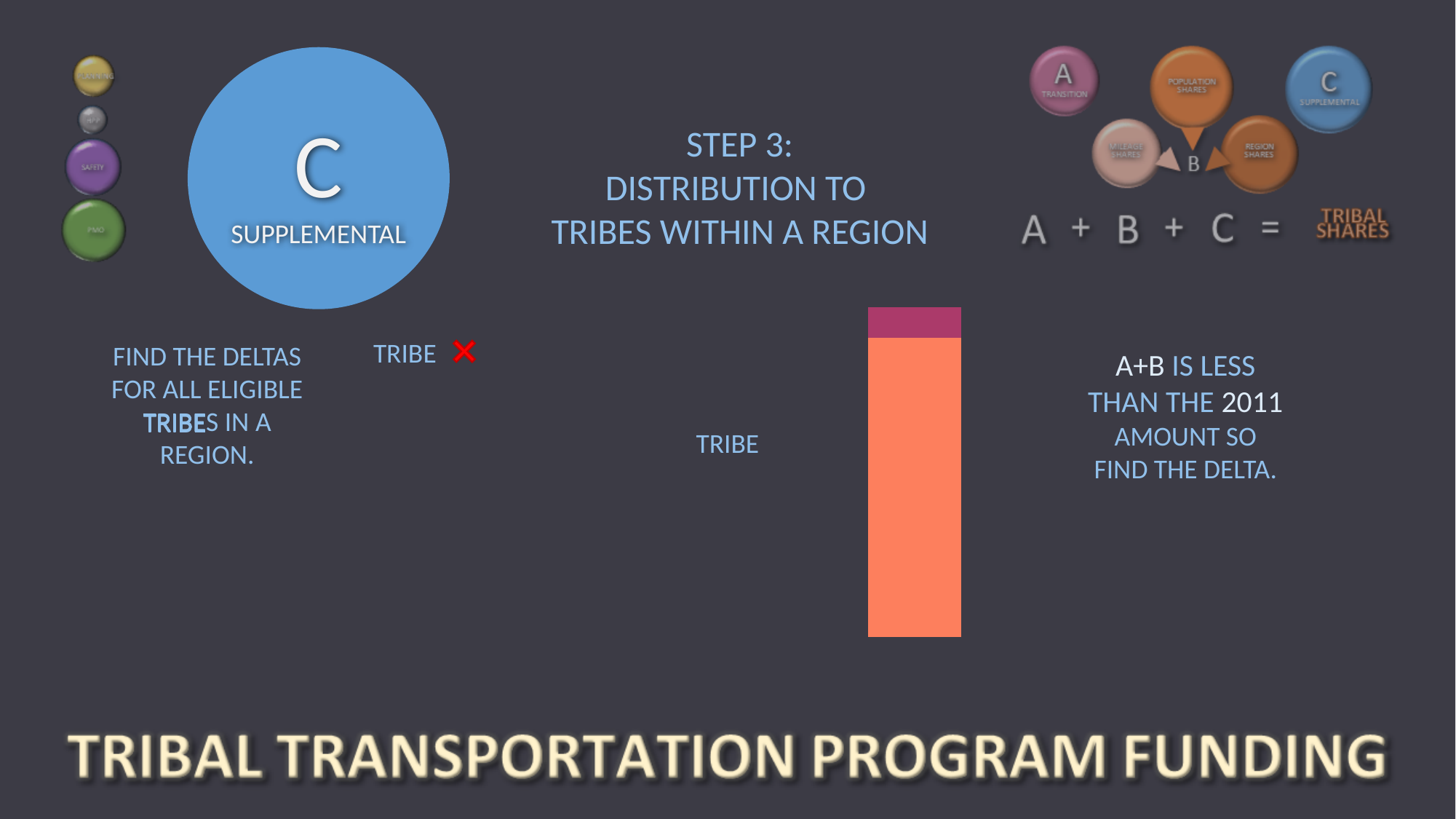
Which segment of the stacked bar is larger, the orange one or the purple one at the top? the orange one How many coloured segments make up the stacked bar on the slide? 2 How many bars does the chart on the slide contain? 1 What kind of chart is shown in the middle of the slide? bar chart